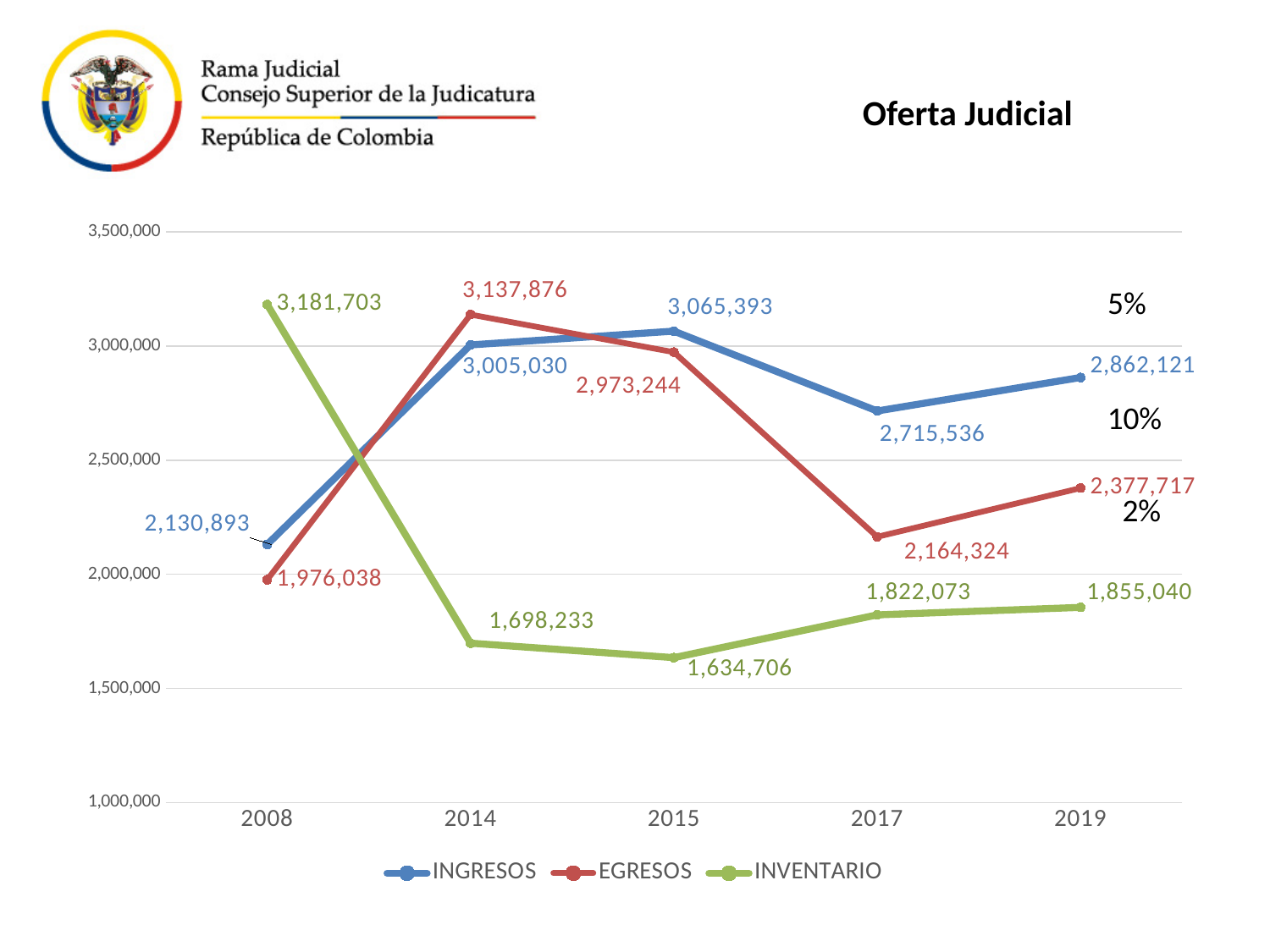
In which year is INVENTARIO lowest? 2015 Is the value of INVENTARIO in 2017 greater or less than 2,000,000? less Does INVENTARIO rise or fall between 2008 and 2014? fall What is the value of INGRESOS in 2015? 3,065,393 How many years are shown on the x axis? 5 In which year is EGRESOS highest? 2014 What is the value of INVENTARIO in 2008? 3,181,703 What is the value of EGRESOS in 2017? 2,164,324 What is the difference between INGRESOS and EGRESOS in 2019? 484,404 What kind of chart is shown? line chart How many series does the legend list? 3 Which is larger in 2014, INGRESOS or EGRESOS? EGRESOS